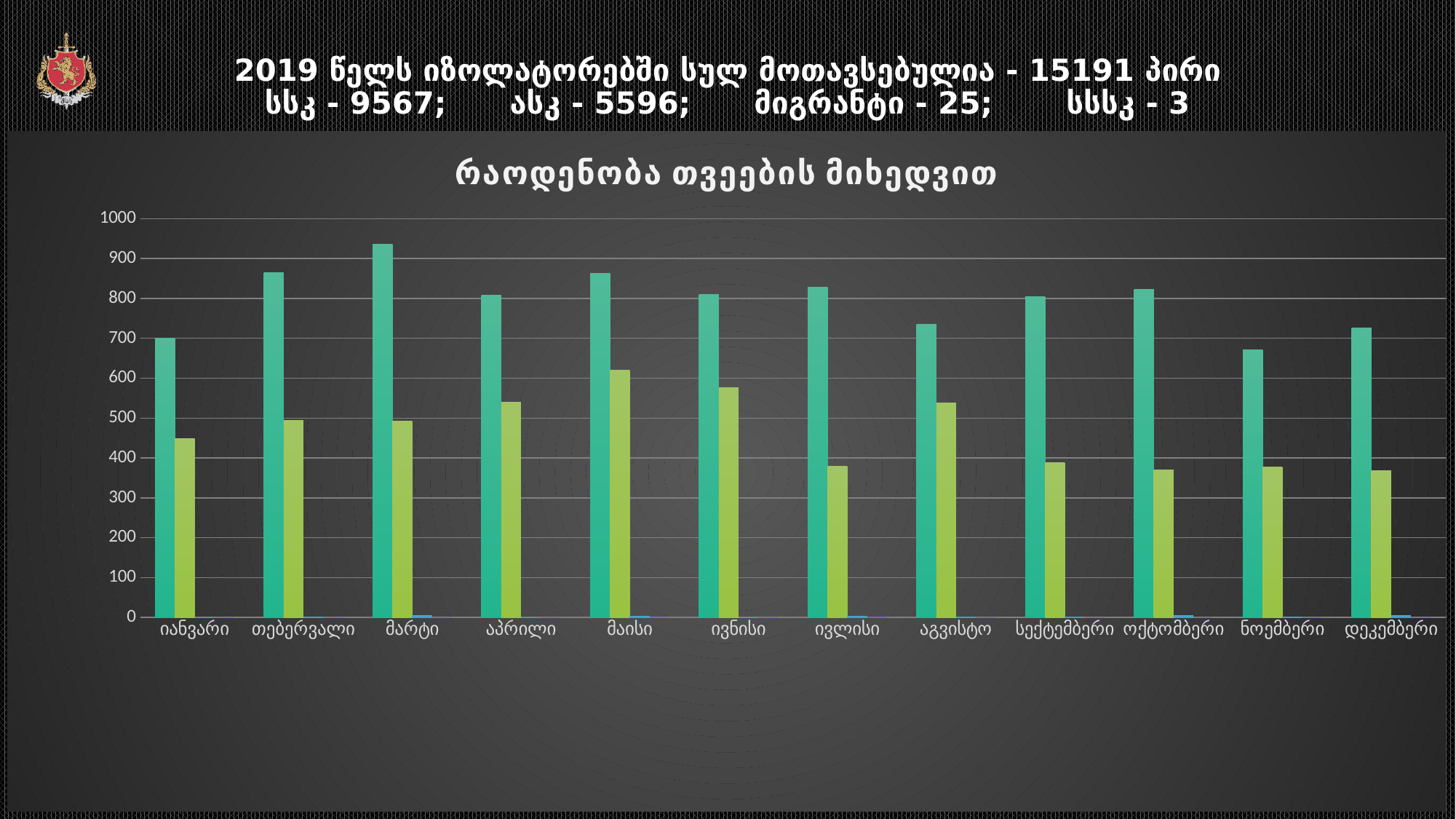
Which is larger: the yellow-green bar for მაისი or the yellow-green bar for ივლისი? მაისი Which month has the tallest yellow-green (second) bar? მაისი Is the yellow-green bar for მაისი greater or less than 600? greater Is the yellow-green bar for ივლისი greater or less than 400? less Which is larger: the teal bar for მარტი or the teal bar for იანვარი? მარტი Is the teal bar for ნოემბერი greater or less than 700? less What kind of chart is shown on the slide? bar chart What is the title of the chart? რაოდენობა თვეების მიხედვით How many months (categories) are shown on the x axis of the chart? 12 Which month has the tallest teal (first) bar? მარტი